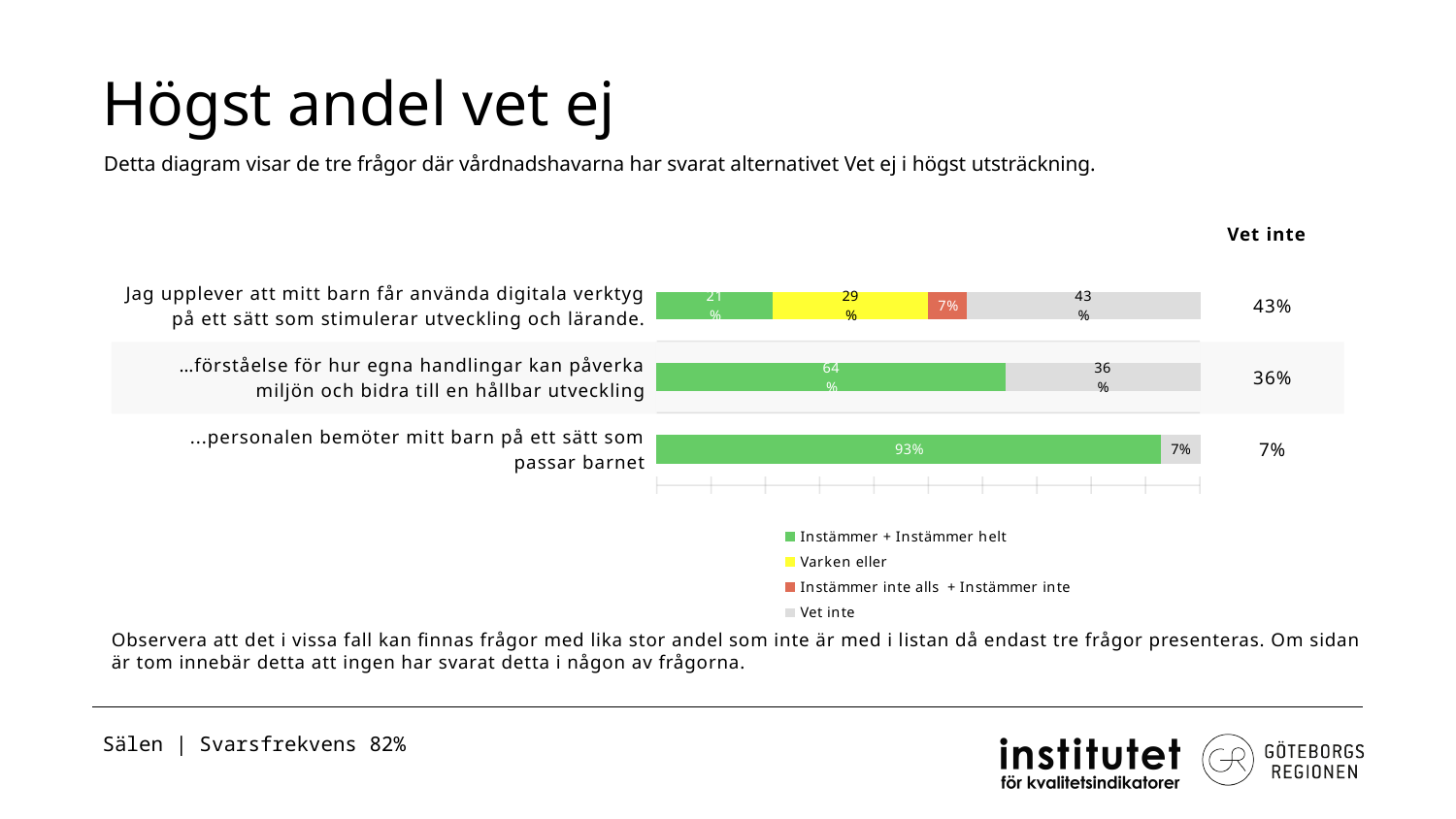
Which is larger: the 'Instämmer + Instämmer helt' share for the sustainable development question or for the 'personalen bemöter mitt barn' question? ...personalen bemöter mitt barn på ett sätt som passar barnet What kind of chart is shown on the slide? Stacked bar chart What is the 'Varken eller' share for 'Jag upplever att mitt barn får använda digitala verktyg på ett sätt som stimulerar utveckling och lärande'? 29% What is the 'Instämmer + Instämmer helt' share for '...personalen bemöter mitt barn på ett sätt som passar barnet'? 93% What is the difference between the 'Vet inte' share for the digital tools question (43%) and the sustainable development question (36%)? 7 percentage points How many series does the legend list? 4 Which question has the highest 'Vet inte' share? Jag upplever att mitt barn får använda digitala verktyg på ett sätt som stimulerar utveckling och lärande What is the 'Instämmer + Instämmer helt' share for '…förståelse för hur egna handlingar kan påverka miljön och bidra till en hållbar utveckling'? 64% Which question has the lowest 'Vet inte' share? ...personalen bemöter mitt barn på ett sätt som passar barnet What is the title of the column to the right of the chart? Vet inte What is the 'Vet inte' share for 'Jag upplever att mitt barn får använda digitala verktyg på ett sätt som stimulerar utveckling och lärande'? 43% How many questions (categories) are shown in the chart? 3